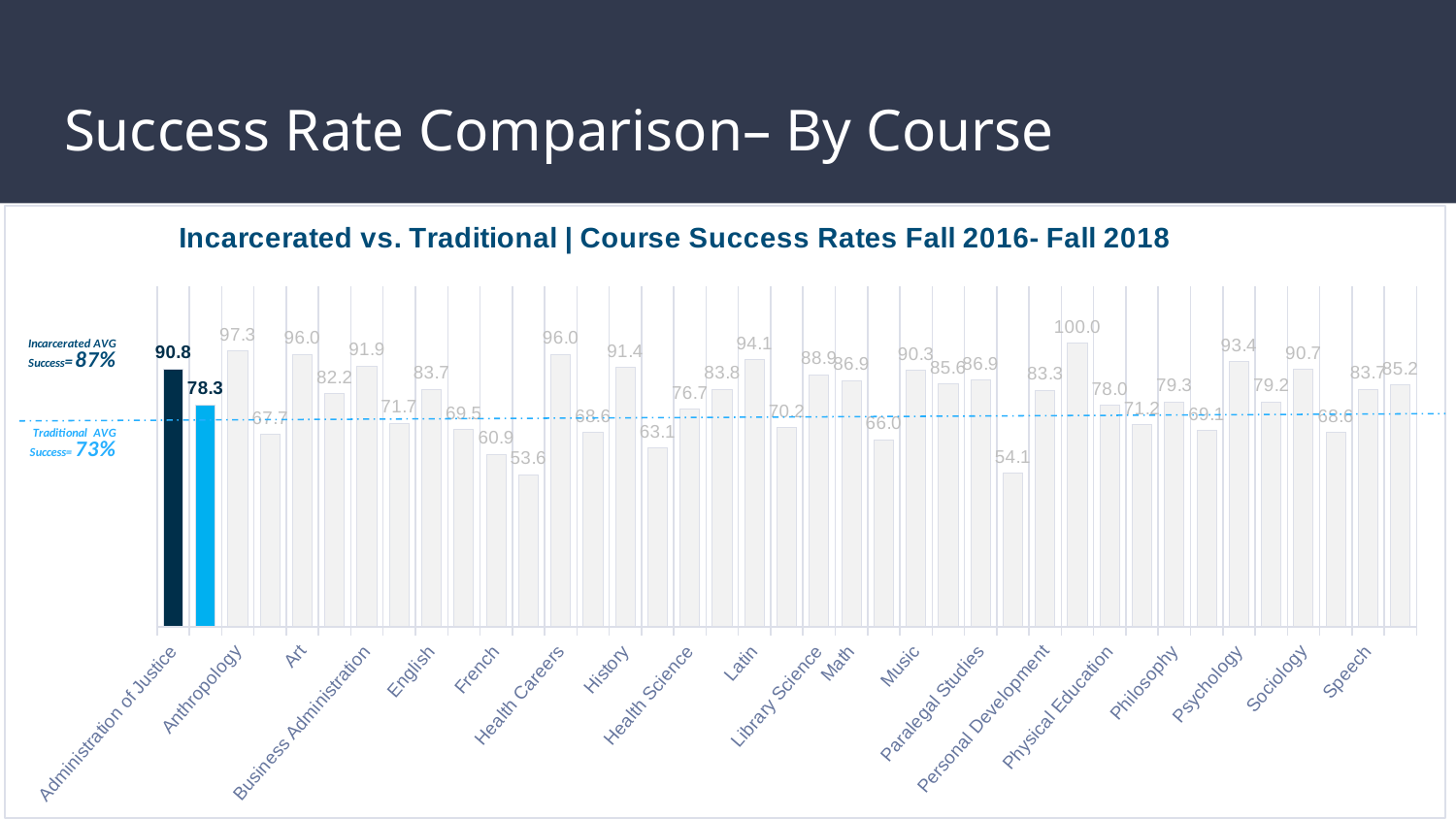
What is the incarcerated success rate (dark bar) for Administration of Justice? 90.8 What is the Traditional AVG Success rate shown on the chart? 73% By how many percentage points does the Incarcerated AVG Success exceed the Traditional AVG Success? 14 What is the highest success rate value labelled on the chart? 100.0 For Administration of Justice, which is larger: the incarcerated success rate or the traditional success rate? Incarcerated What kind of chart is shown on the slide? Bar chart What is the Incarcerated AVG Success rate shown on the chart? 87% How many courses are listed along the x axis of the chart? 20 What is the title of the chart? Incarcerated vs. Traditional | Course Success Rates Fall 2016- Fall 2018 What is the difference between the incarcerated and traditional success rates for Administration of Justice? 12.5 What is the traditional success rate (light blue bar) for Administration of Justice? 78.3 What is the lowest success rate value labelled on the chart? 53.6